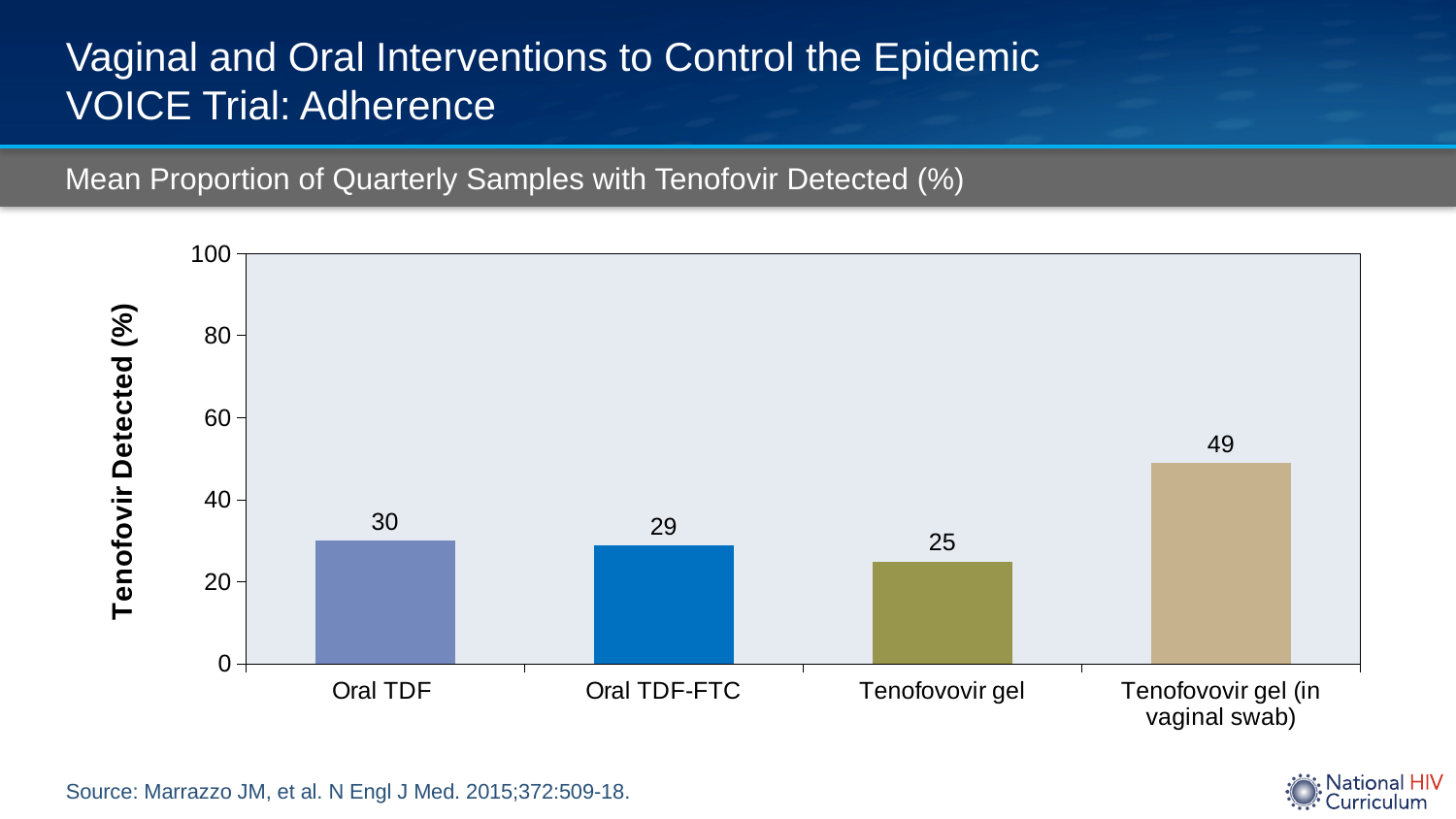
What is the value for Oral TDF? 30 What is the value for Tenofovovir gel (in vaginal swab)? 49 How many categories are shown on the x axis? 4 What kind of chart is shown on the slide? Bar chart Which category has the highest value? Tenofovovir gel (in vaginal swab) What is the value for Oral TDF-FTC? 29 What is the value for Tenofovovir gel? 25 Is the value for Tenofovovir gel (in vaginal swab) greater or less than 40? greater What is the difference between the values for Tenofovovir gel (in vaginal swab) and Tenofovovir gel? 24 Which category has the lowest value? Tenofovovir gel What is the difference between the values for Oral TDF and Oral TDF-FTC? 1 Which is larger, the value for Oral TDF or the value for Tenofovovir gel? Oral TDF